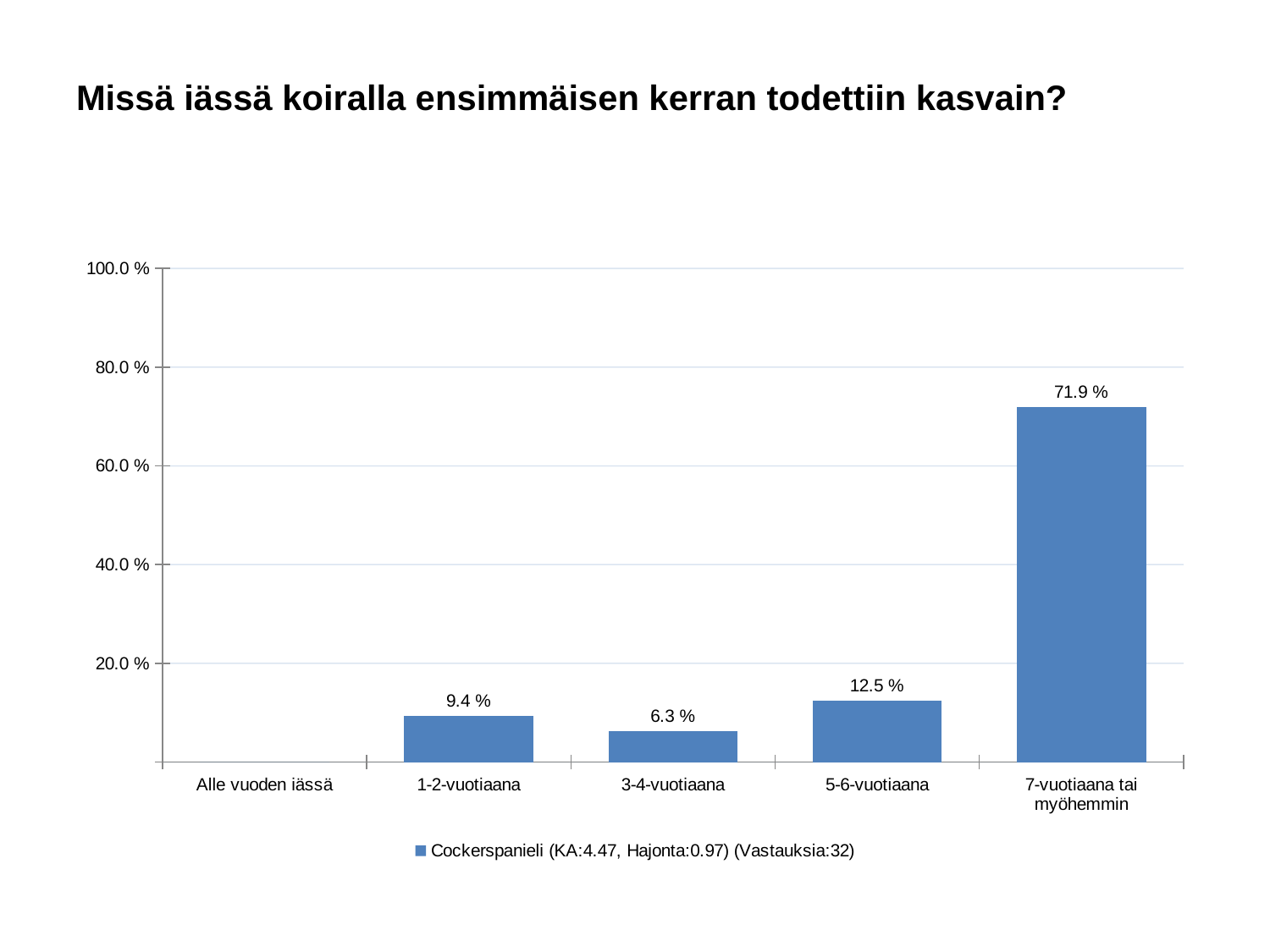
What is the value for 5-6-vuotiaana? 12.5 % Which category has the highest value? 7-vuotiaana tai myöhemmin Which is larger, the value for 1-2-vuotiaana or the value for 3-4-vuotiaana? 1-2-vuotiaana What kind of chart is shown on the slide? bar chart Which category with a visible bar has the lowest value? 3-4-vuotiaana What is the value for 3-4-vuotiaana? 6.3 % What is the legend entry for the series? Cockerspanieli (KA:4.47, Hajonta:0.97) (Vastauksia:32) Is the value for 7-vuotiaana tai myöhemmin greater or less than 60.0 %? greater What is the value for 1-2-vuotiaana? 9.4 % How many categories are shown on the x axis? 5 What is the value for 7-vuotiaana tai myöhemmin? 71.9 % What is the difference between the values for 5-6-vuotiaana and 1-2-vuotiaana? 3.1 %